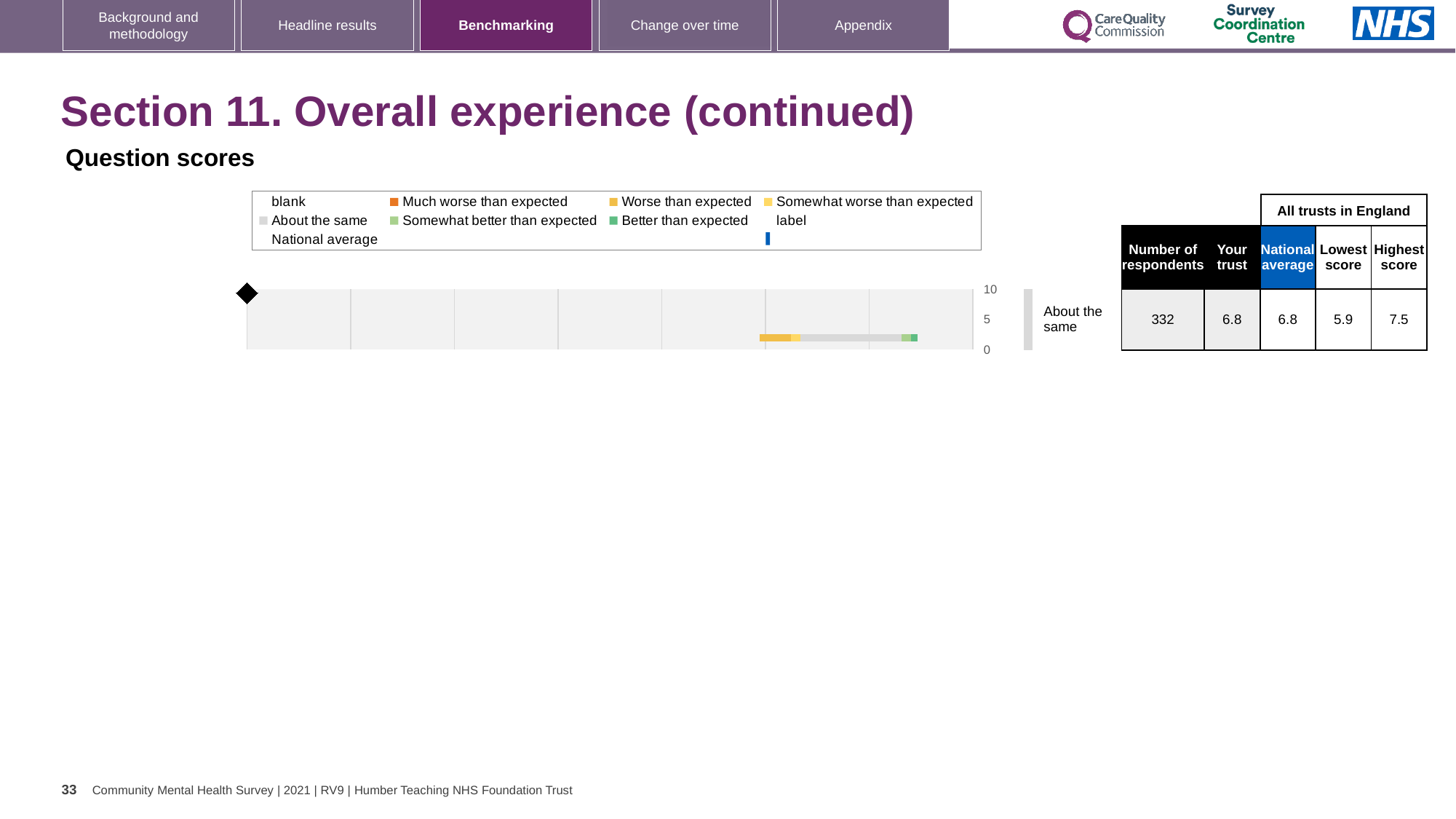
What colour is the legend marker for 'Much worse than expected'? orange In the table beside the chart, what is the lowest score among all trusts in England? 5.9 In the table beside the chart, is the 'Your trust' score higher than, lower than, or the same as the national average? the same In the table beside the chart, what is the highest score among all trusts in England? 7.5 In the table beside the chart, what is the number of respondents? 332 In the table beside the chart, what is the 'Your trust' score? 6.8 In the table beside the chart, what is the national average score? 6.8 What type of chart is shown under 'Question scores'? bar chart How many bars are plotted in the chart? 1 In the table beside the chart, what is the difference between the highest score and the lowest score? 1.6 What category label is shown next to the bar in the chart? About the same What is the highest value shown on the chart's axis? 10